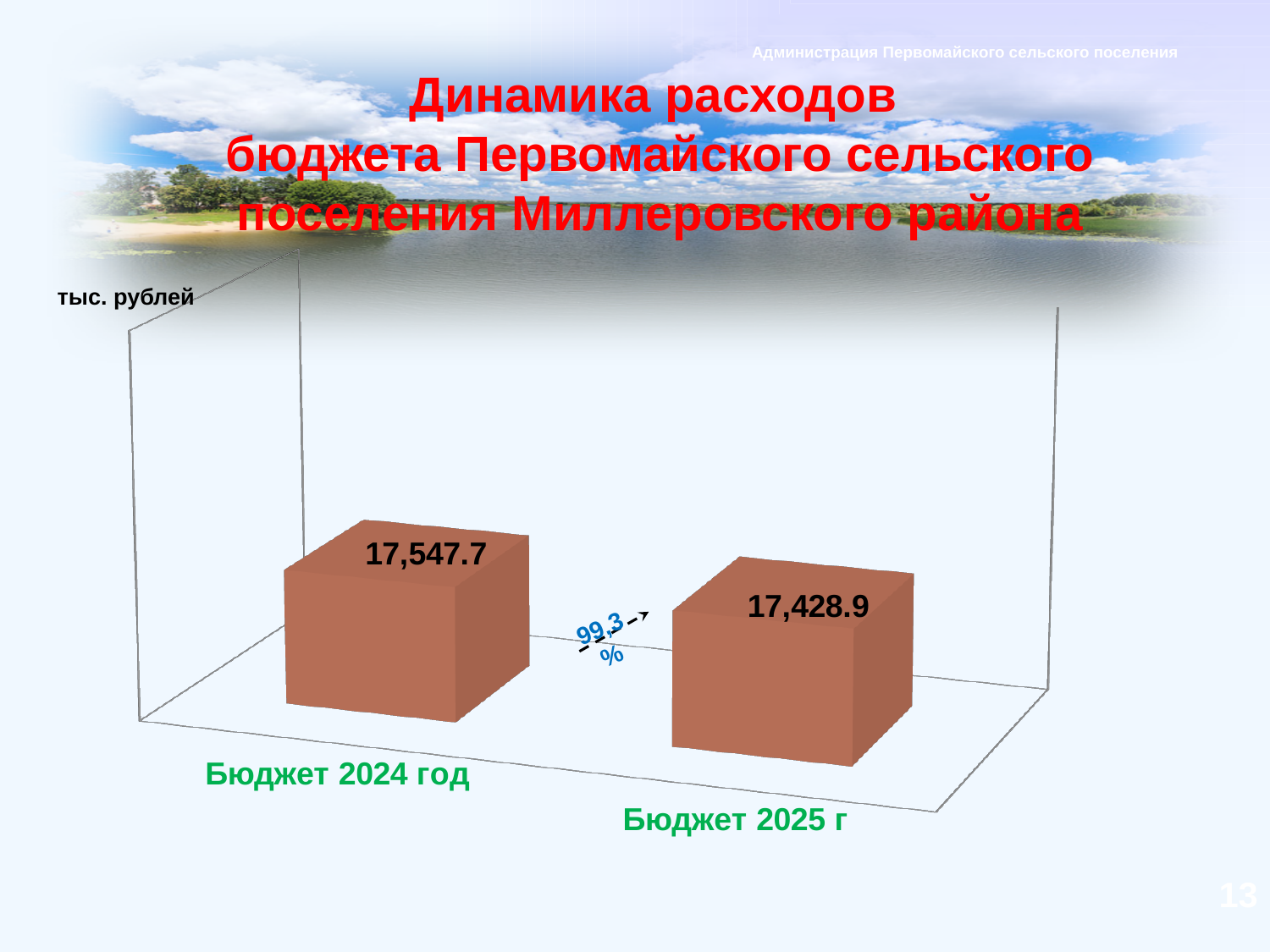
What is the value shown for Бюджет 2024 год? 17,547.7 What kind of chart is shown on the slide? Bar chart Which category has the highest value on the chart? Бюджет 2024 год What unit of measurement is indicated on the chart? тыс. рублей Which category has the higher value, Бюджет 2024 год or Бюджет 2025 г? Бюджет 2024 год What percentage is written on the arrow between the two bars? 99.3 % What is the value shown for Бюджет 2025 г? 17,428.9 Do the values rise or fall from Бюджет 2024 год to Бюджет 2025 г? Fall Which category has the lowest value on the chart? Бюджет 2025 г What is the difference between the values for Бюджет 2024 год and Бюджет 2025 г? 118.8 How many bars are plotted on the chart? 2